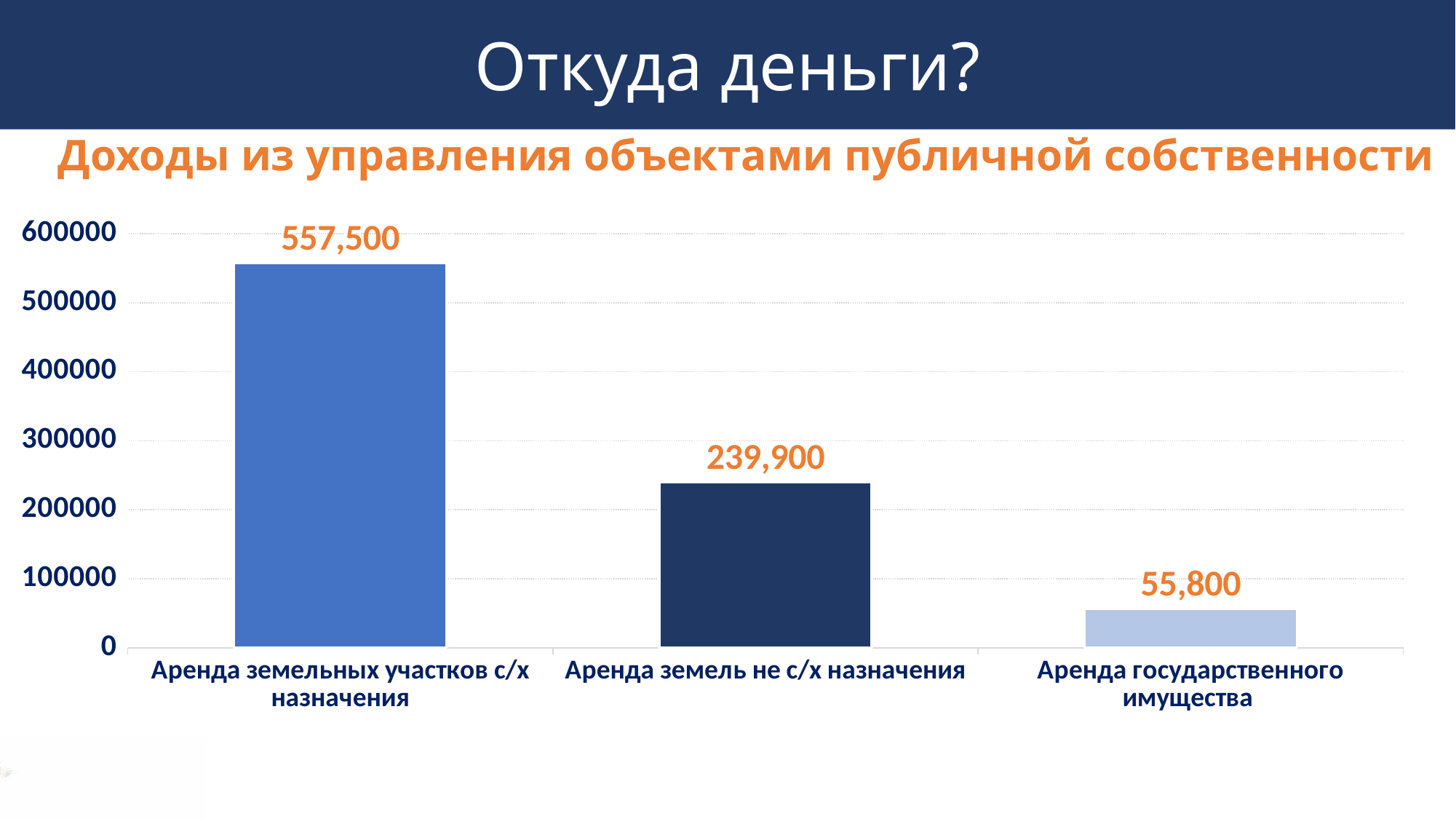
What is the difference between the values for "Аренда земельных участков с/х назначения" and "Аренда земель не с/х назначения"? 317,600 Which is larger: the value for "Аренда земель не с/х назначения" or for "Аренда государственного имущества"? Аренда земель не с/х назначения Is the value for "Аренда земель не с/х назначения" greater or less than 300000? less What is the value for "Аренда земельных участков с/х назначения"? 557,500 Which category has the highest value? Аренда земельных участков с/х назначения What is the difference between the values for "Аренда земель не с/х назначения" and "Аренда государственного имущества"? 184,100 What is the value for "Аренда земель не с/х назначения"? 239,900 What is the value for "Аренда государственного имущества"? 55,800 What kind of chart is shown on the slide? bar chart What is the title of the chart? Доходы из управления объектами публичной собственности Which category has the lowest value? Аренда государственного имущества How many categories are shown in the chart? 3